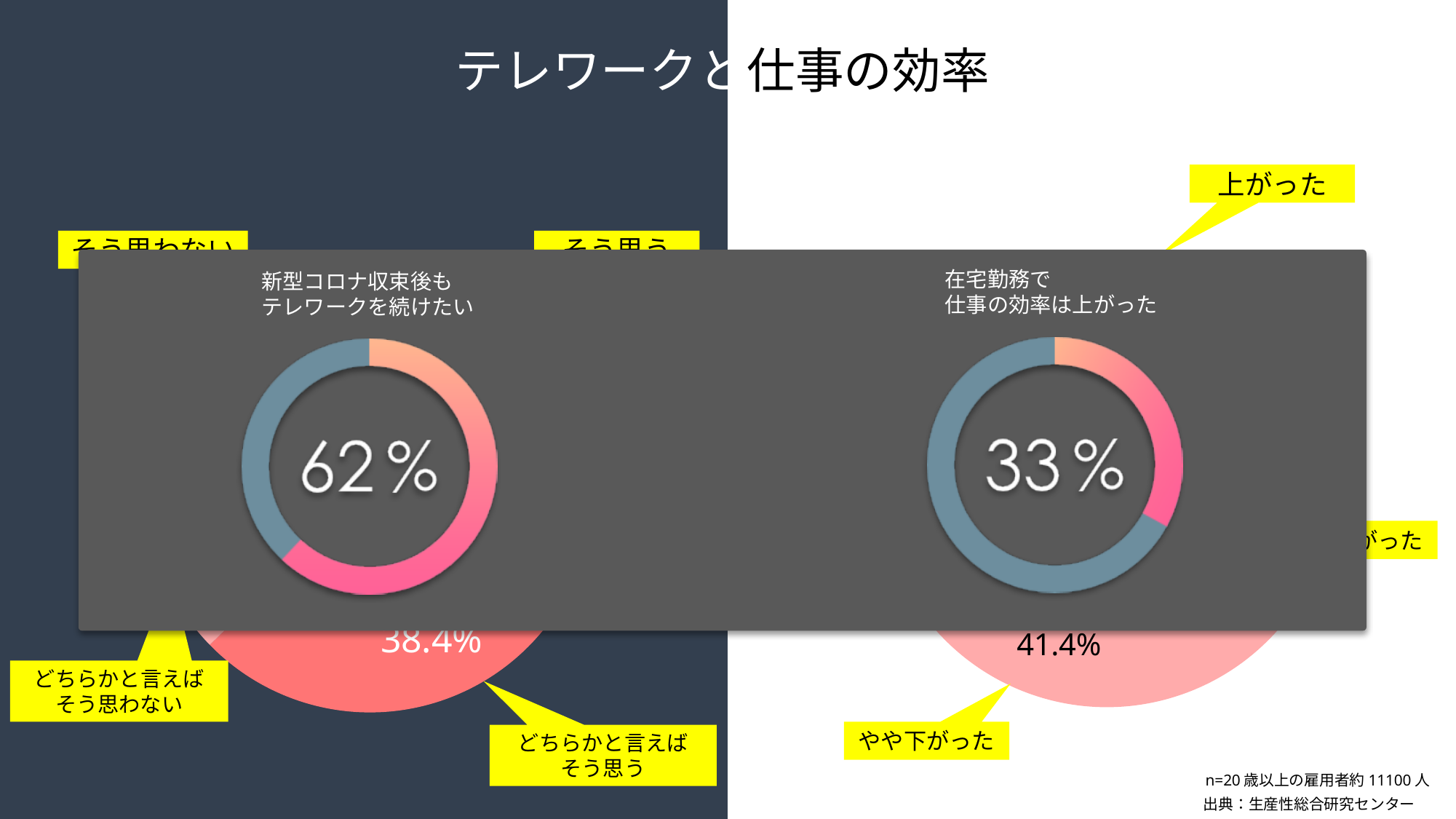
Which of the two donut charts shows the larger percentage, 新型コロナ収束後もテレワークを続けたい or 在宅勤務で仕事の効率は上がった? 新型コロナ収束後もテレワークを続けたい Is the value shown in the 新型コロナ収束後もテレワークを続けたい donut chart greater or less than 50%? greater In the donut chart titled 在宅勤務で仕事の効率は上がった, what percentage is shown in the centre? 33% How many category labels (yellow callouts) are attached to the left pie chart on the dark background? 4 In the donut chart titled 新型コロナ収束後もテレワークを続けたい, what percentage is shown in the centre? 62% Is the value shown in the 在宅勤務で仕事の効率は上がった donut chart greater or less than 50%? less What is the difference in percentage points between the 62% in the left donut chart and the 33% in the right donut chart? 29 How many donut charts are shown in the grey overlay panel? 2 What kind of chart is used in the grey overlay panel to show the 62% and 33% values? donut chart According to the note at the bottom right, what is the source (出典) of the data? 生産性総合研究センター What is the title of the slide? テレワークと仕事の効率